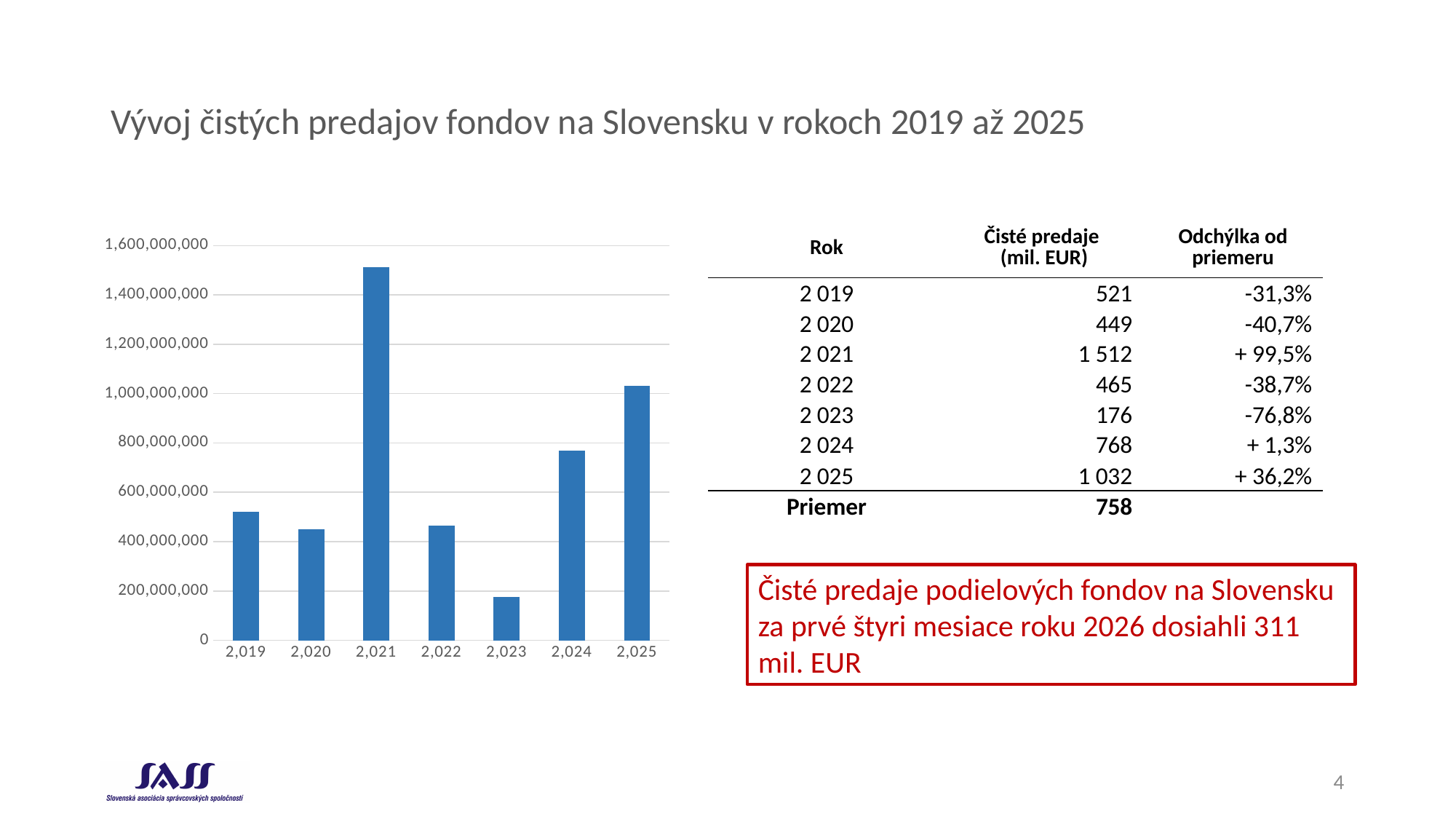
Which is larger, the value for 2024 or the value for 2025? 2025 Which year has the highest bar in the chart? 2021 Is the value for 2023 greater or less than 200,000,000? less Is the value for 2025 greater or less than 1,000,000,000? greater Do the values rise or fall from 2023 to 2025? rise Is the value for 2024 greater or less than 800,000,000? less What kind of chart is shown on the slide? bar chart How many years (bars) are plotted in the chart? 7 What is the title of the slide containing the chart? Vývoj čistých predajov fondov na Slovensku v rokoch 2019 až 2025 Which is larger, the value for 2019 or the value for 2020? 2019 Which year has the lowest bar in the chart? 2023